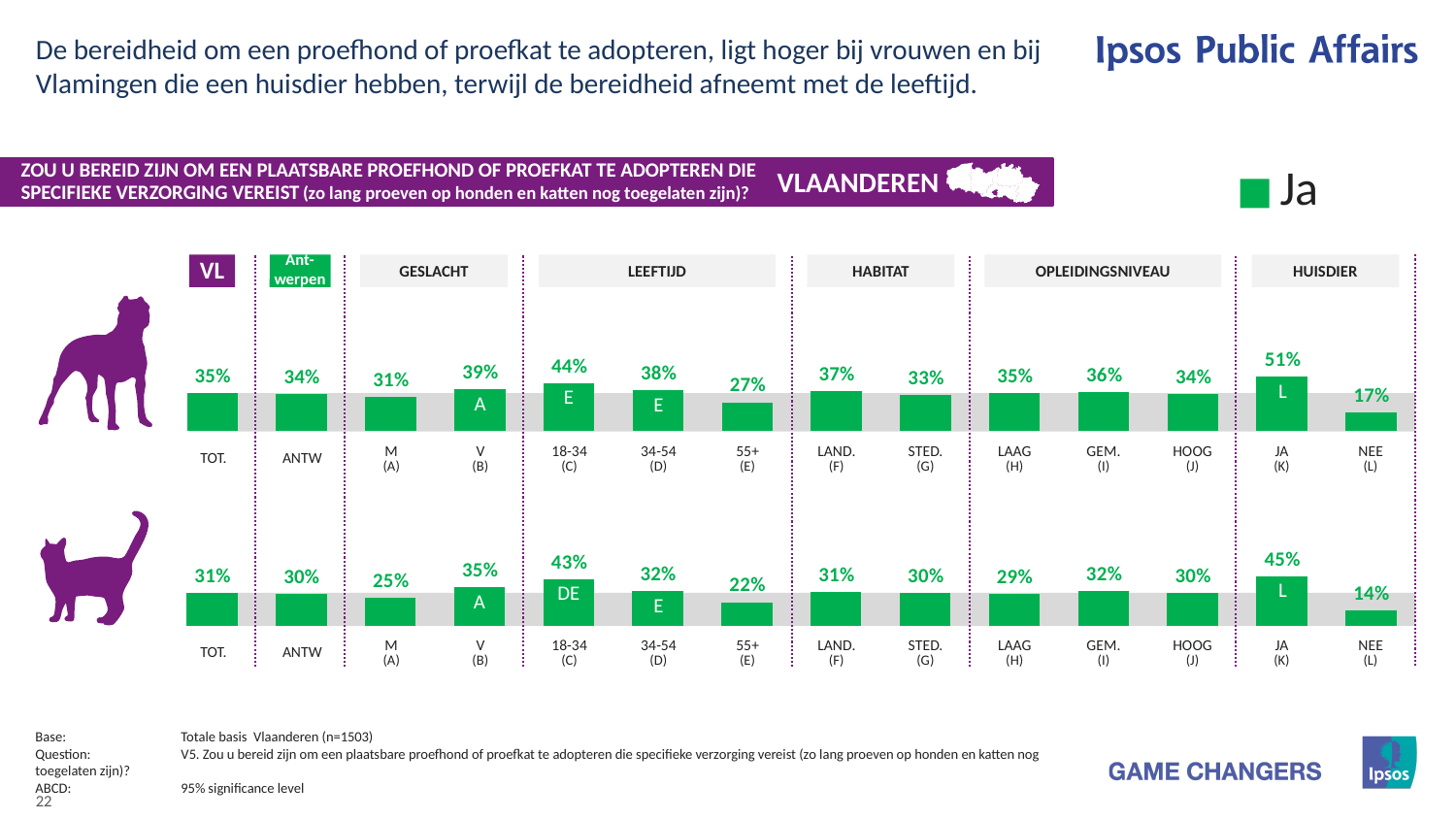
In the bottom chart (cat), do the values rise or fall across the LEEFTIJD groups from 18-34 to 55+? Fall What kind of chart is used on this slide? Bar chart In the bottom chart (cat), which category has the lowest value? NEE (L) In the top chart (dog), what is the value for HOOG (J) under OPLEIDINGSNIVEAU? 34% What does the legend entry on the slide say? Ja How many categories are plotted in the top chart (dog)? 14 In the bottom chart (cat), what is the value for V (B) under GESLACHT? 35% In the top chart (dog), what is the value for TOT.? 35% In the top chart (dog), what is the difference between the values for 18-34 (C) and 55+ (E)? 17% In the bottom chart (cat), what is the difference between the values for JA (K) and NEE (L)? 31% In the bottom chart (cat), which is larger: the value for LAND. (F) or STED. (G)? LAND. (F) In the top chart (dog), which category has the highest value? JA (K)